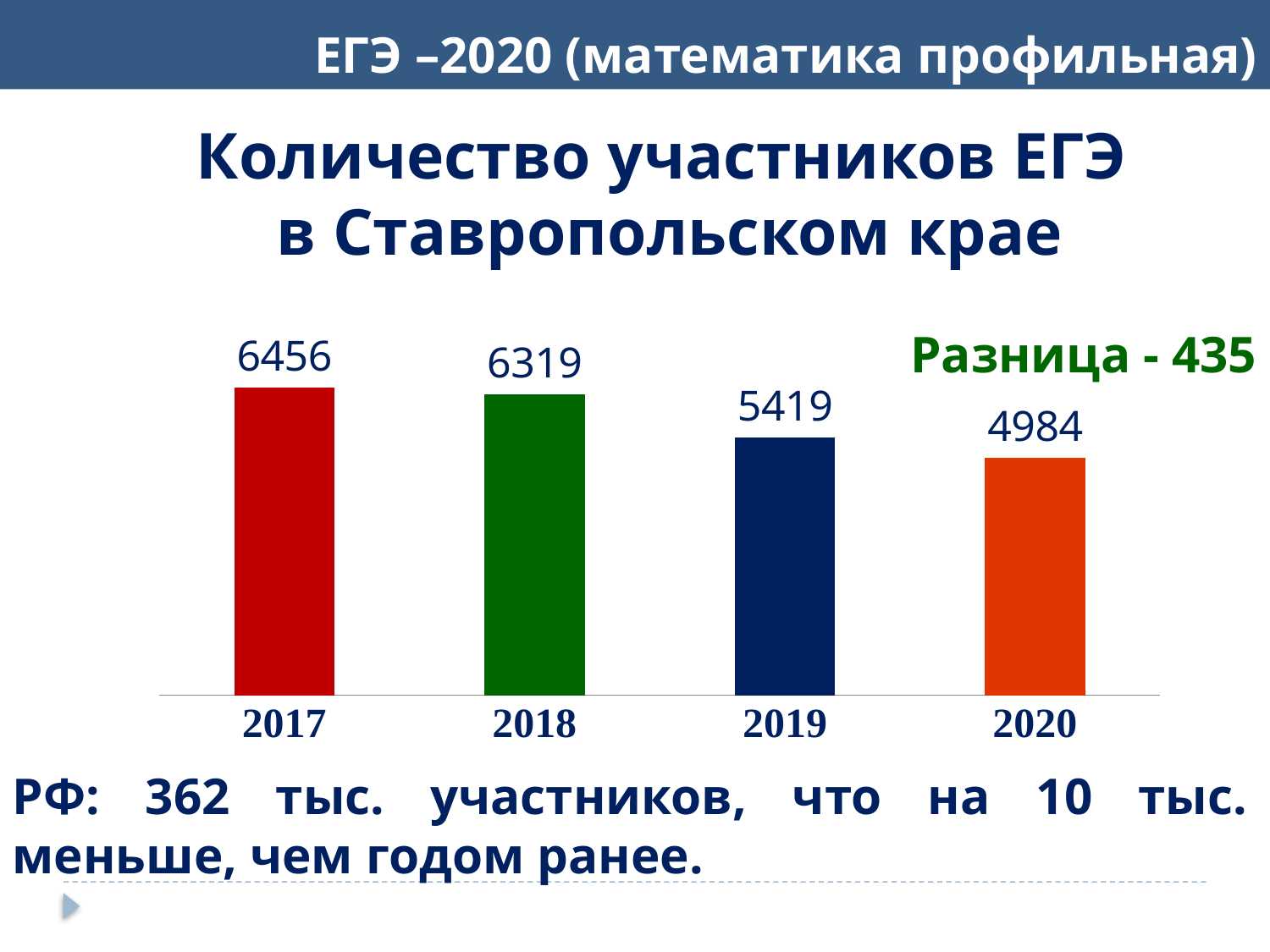
What is the difference between the 2017 and 2018 values? 137 Which is larger, the value for 2018 or the value for 2019? 2018 How many years are shown on the chart? 4 What colour is the bar for 2018? green What is the number of participants in 2019? 5419 What is the number of participants in 2017? 6456 Do the values rise or fall from 2017 to 2020? fall Which year has the highest number of participants? 2017 What is the number of participants in 2020? 4984 Which year has the lowest number of participants? 2020 What is the difference between the 2019 and 2020 values? 435 What kind of chart is shown? bar chart